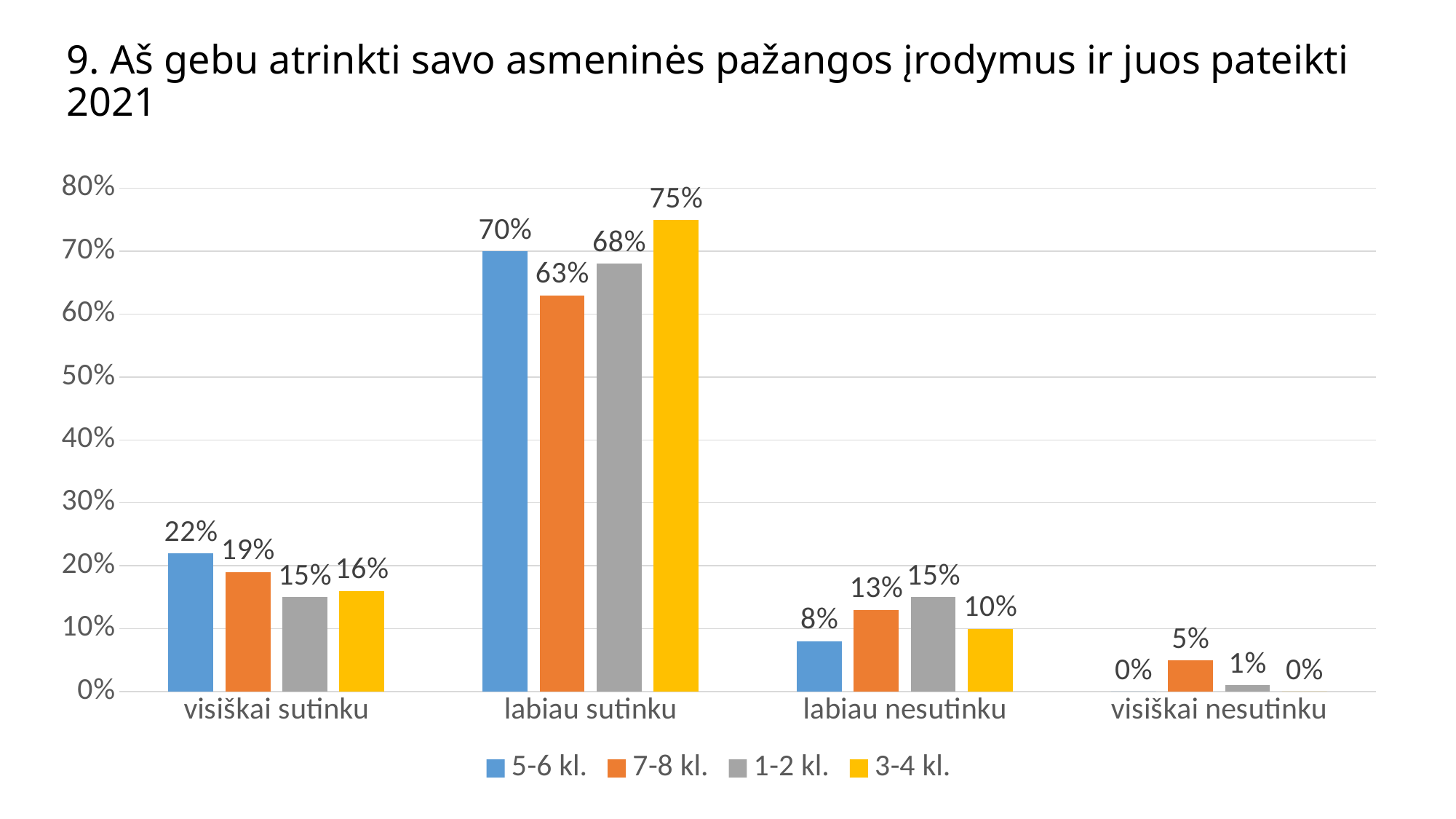
Which series has the lowest value in the 'labiau nesutinku' category? 5-6 kl. How many series does the legend list? 4 What is the value for 7-8 kl. in the 'visiškai nesutinku' category? 5% How many categories are shown on the x axis? 4 Which series has the highest value in the 'labiau sutinku' category? 3-4 kl. What is the value for 5-6 kl. in the 'labiau sutinku' category? 70% What kind of chart is shown on the slide? Bar chart Which colour represents the 1-2 kl. series? Grey Which is larger: the 1-2 kl. value for 'visiškai sutinku' or the 1-2 kl. value for 'labiau nesutinku'? They are equal (15%) What is the value for 3-4 kl. in the 'visiškai sutinku' category? 16% Which is larger: the 7-8 kl. value for 'visiškai sutinku' or the 3-4 kl. value for 'visiškai sutinku'? 7-8 kl. What is the difference between the 5-6 kl. and 7-8 kl. values in the 'labiau sutinku' category? 7%